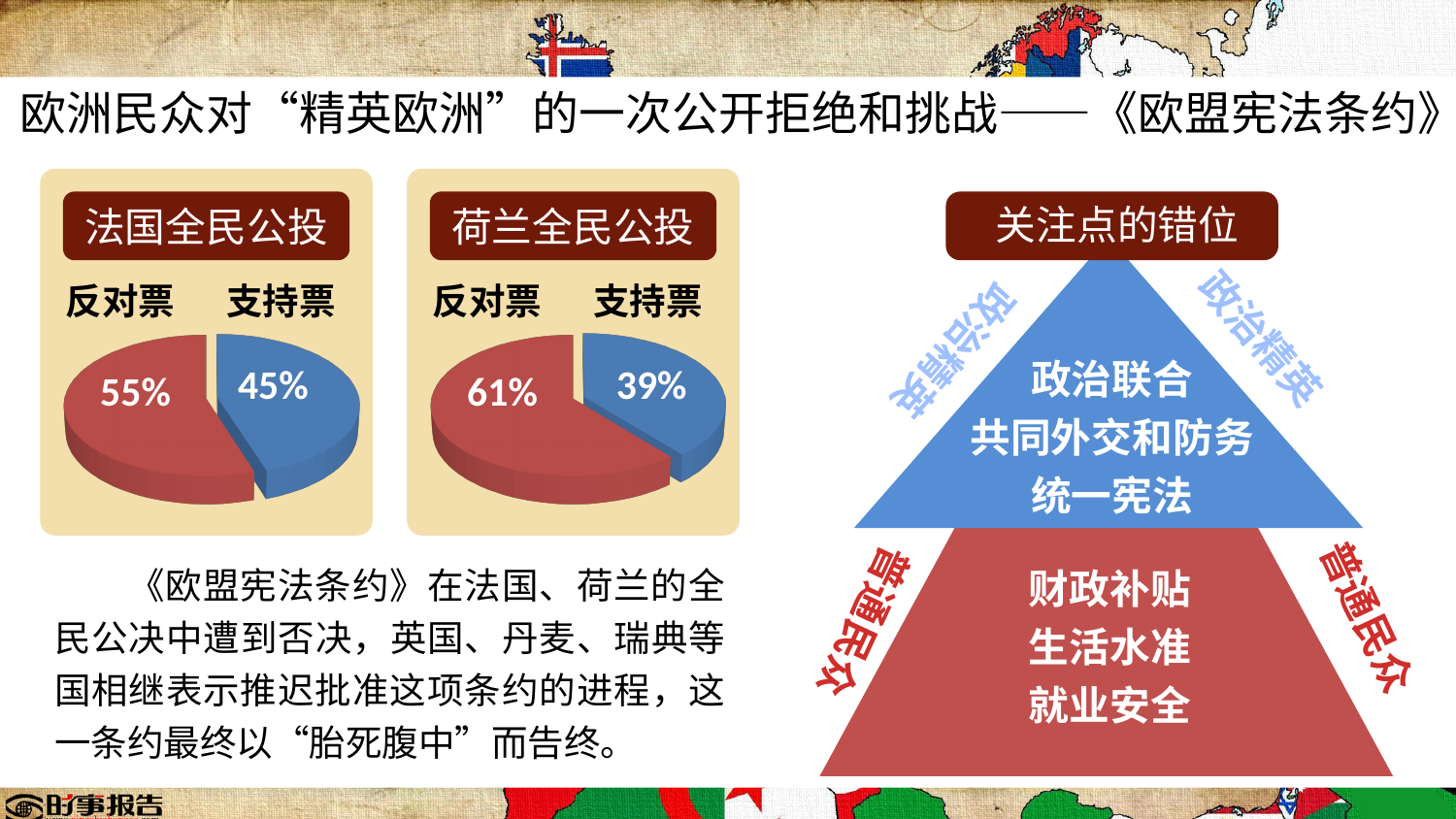
In the 法国全民公投 chart, what colour is the 支持票 slice? Blue In the 法国全民公投 chart, what share of the pie is 反对票? 55% Which chart shows the higher 反对票 share, 法国全民公投 or 荷兰全民公投? 荷兰全民公投 How many slices does the 荷兰全民公投 pie chart have? 2 In the 法国全民公投 chart, what share of the pie is 支持票? 45% What type of chart is used for the 法国全民公投 data? Pie chart In the 荷兰全民公投 chart, which slice is the smallest? 支持票 In the 法国全民公投 chart, what is the difference between the 反对票 and 支持票 shares? 10% In the 荷兰全民公投 chart, what is the difference between the 反对票 and 支持票 shares? 22% In the 荷兰全民公投 chart, what share of the pie is 支持票? 39% In the 法国全民公投 chart, which slice is larger, 反对票 or 支持票? 反对票 In the 荷兰全民公投 chart, what share of the pie is 反对票? 61%